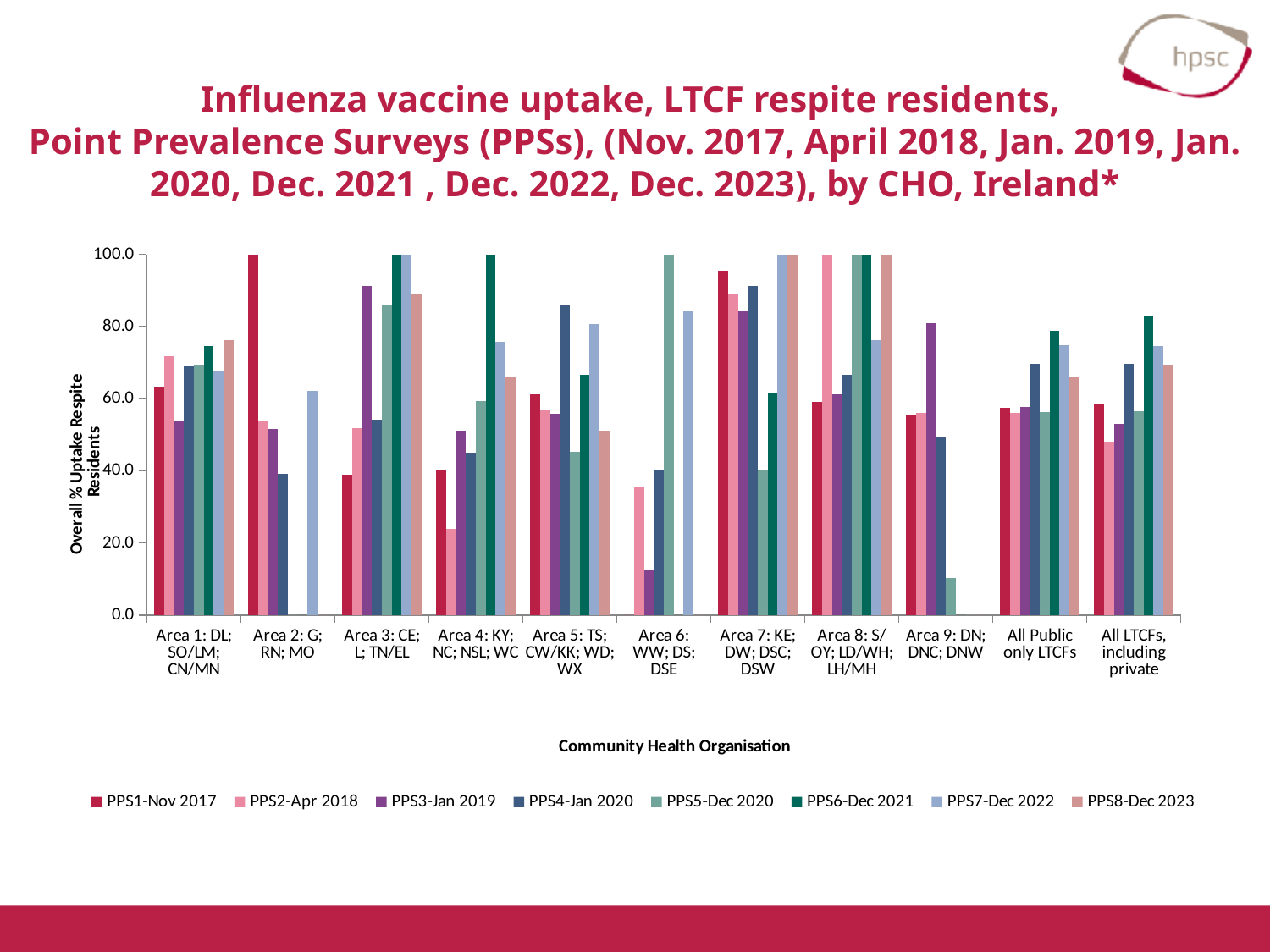
What kind of chart is shown on the slide? Bar chart What is the value for PPS1-Nov 2017 in Area 2: G; RN; MO? 100.0 Which series has the highest value in Area 6: WW; DS; DSE? PPS5-Dec 2020 How many Community Health Organisation categories are shown on the x axis? 11 Is the value for PPS1-Nov 2017 in Area 7: KE; DW; DSC; DSW greater or less than 80? greater How many series does the legend list? 8 Is the value for PPS6-Dec 2021 in All LTCFs, including private greater or less than 80? greater In Area 2: G; RN; MO, which is larger, the value for PPS1-Nov 2017 or PPS7-Dec 2022? PPS1-Nov 2017 What is the value for PPS5-Dec 2020 in Area 6: WW; DS; DSE? 100.0 What is the title of the y axis? Overall % Uptake Respite Residents Is the value for PPS5-Dec 2020 in Area 9: DN; DNC; DNW greater or less than 20? less